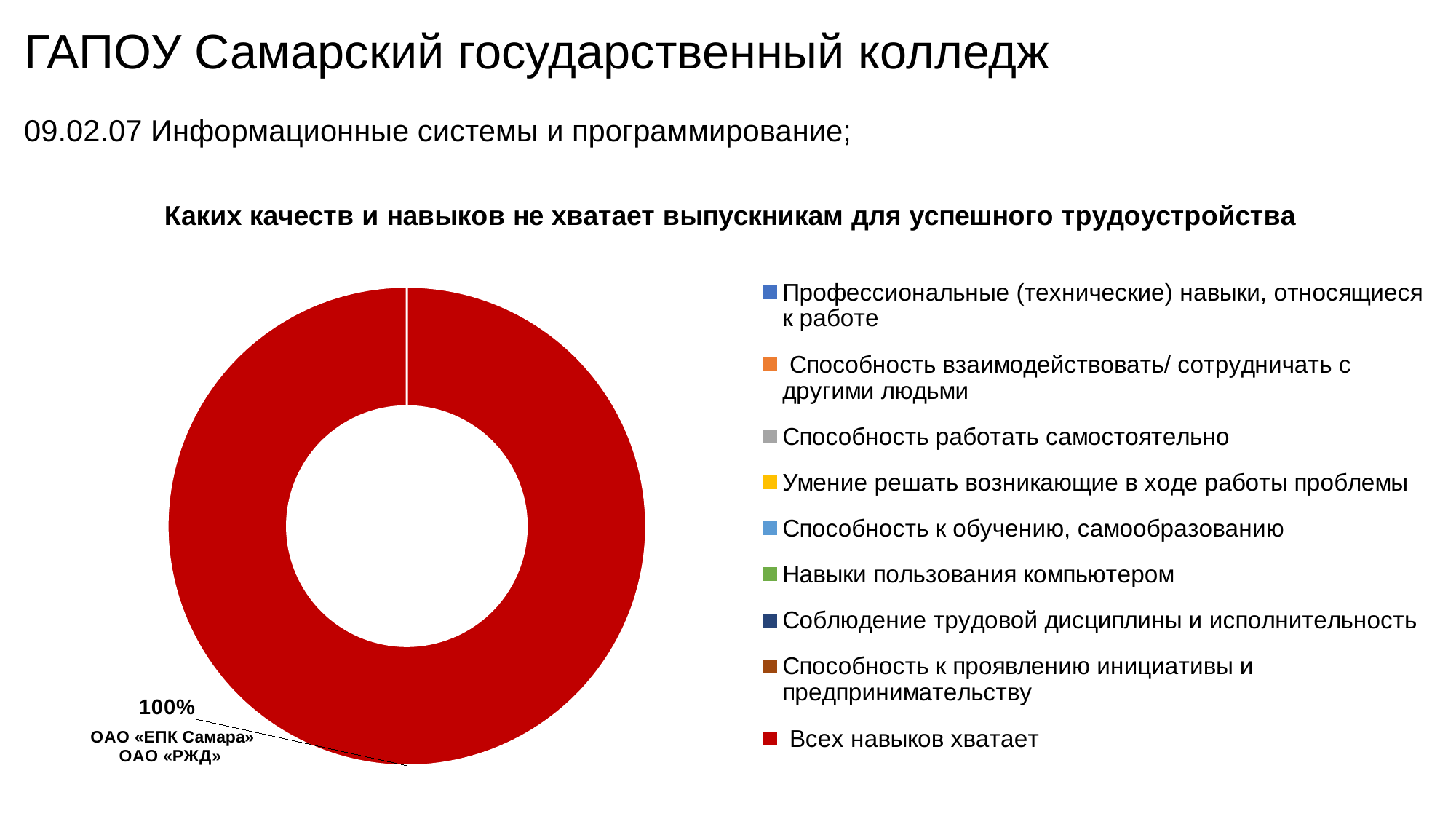
What share of the chart does the category "Всех навыков хватает" take? 100% What colour is the slice representing "Всех навыков хватает"? Red What value is printed as the data label on the chart? 100% How many entries does the chart legend list? 9 What kind of chart is shown on the slide? Doughnut (pie) chart Which organisations are named in the annotation next to the 100% data label? ОАО «ЕПК Самара», ОАО «РЖД» Which category accounts for the largest share of the chart? Всех навыков хватает What is the title of the chart? Каких качеств и навыков не хватает выпускникам для успешного трудоустройства Which legend entry is listed last in the chart legend? Всех навыков хватает Is the share for "Всех навыков хватает" greater or less than 50%? greater